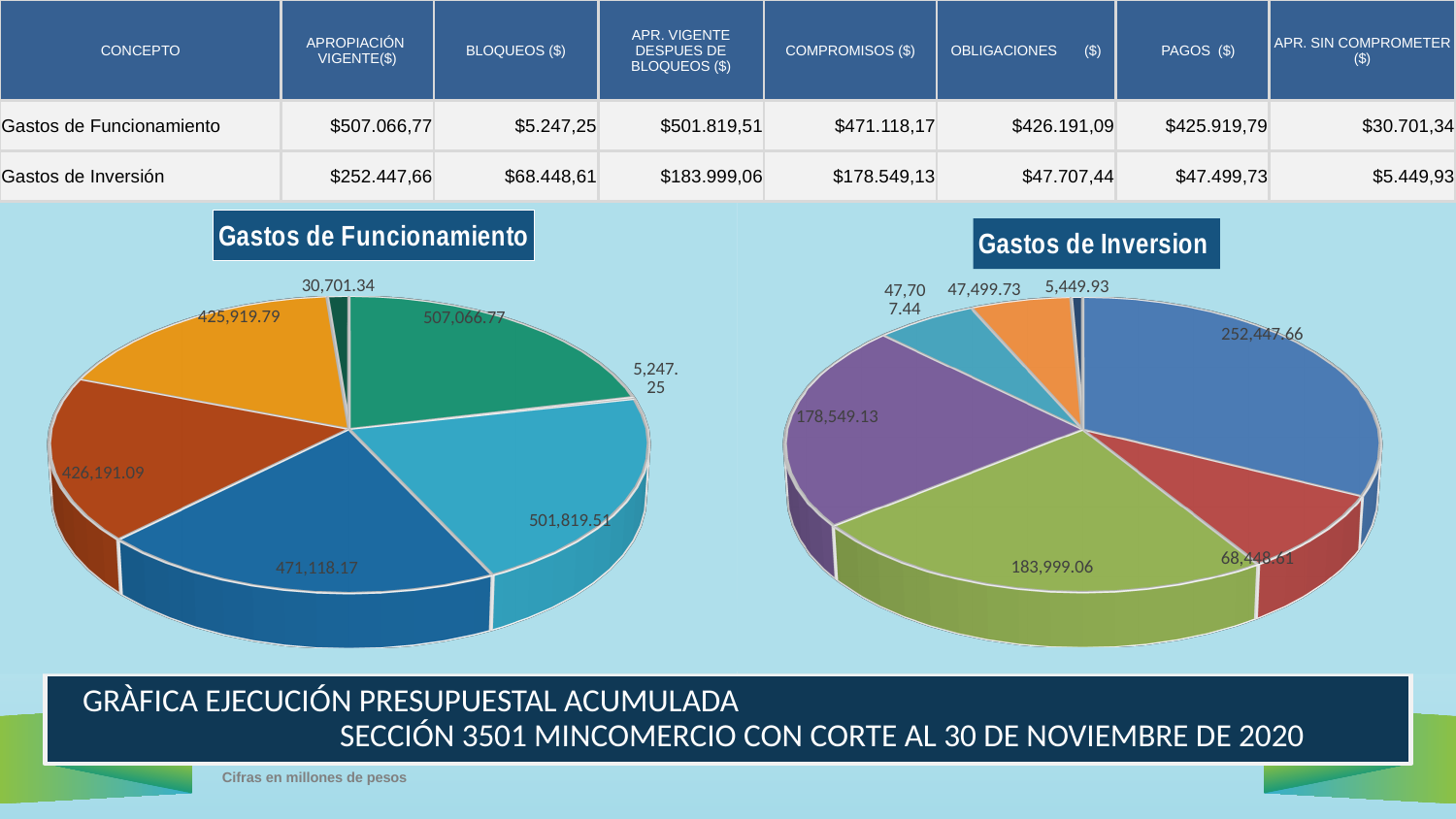
According to the note at the bottom of the slide, in what units are the chart figures expressed? Cifras en millones de pesos How many slices does the Gastos de Inversion pie chart have? 7 In the Gastos de Funcionamiento pie chart, what is the difference between the slices labeled 471,118.17 and 426,191.09? 44,927.08 In the Gastos de Funcionamiento pie chart, what is the smallest labeled value? 5,247.25 In the Gastos de Inversion pie chart, what is the largest labeled value? 252,447.66 In the Gastos de Funcionamiento pie chart, what value is shown on the small dark green slice at the top? 30,701.34 What is the title of the pie chart on the right side of the slide? Gastos de Inversion In the Gastos de Inversion pie chart, what is the difference between the slices labeled 183,999.06 and 178,549.13? 5,449.93 In the Gastos de Funcionamiento pie chart, what is the largest labeled value? 507,066.77 In the Gastos de Inversion pie chart, which is larger: the slice labeled 183,999.06 or the slice labeled 68,448.61? 183,999.06 In the Gastos de Inversion pie chart, what is the smallest labeled value? 5,449.93 What type of chart is the Gastos de Funcionamiento chart? pie chart